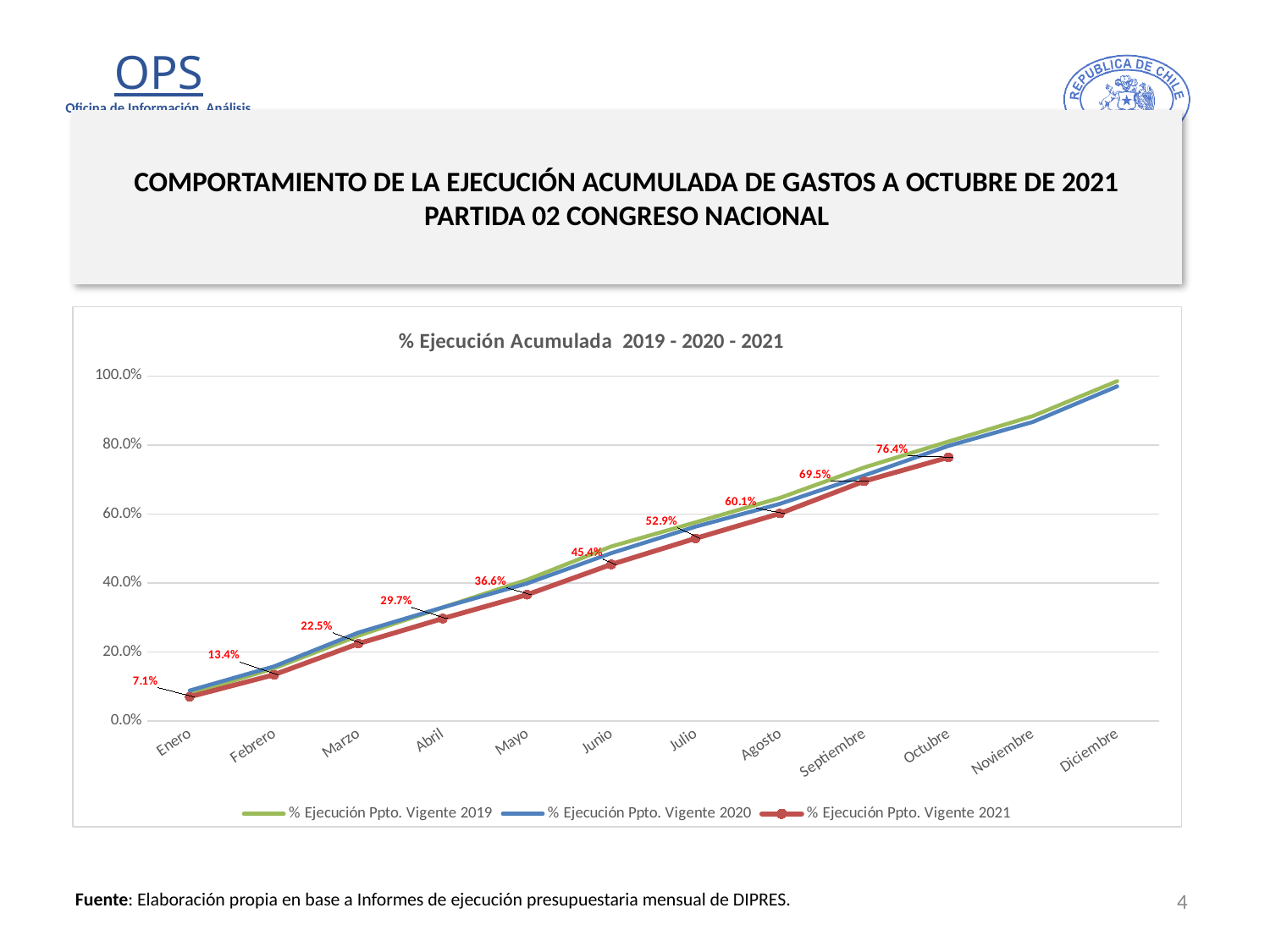
What kind of chart is shown? Line chart What is the value of % Ejecución Ppto. Vigente 2021 for Octubre? 76.4% How many series does the legend list? 3 By how many percentage points does the 2021 value for Octubre exceed the 2021 value for Septiembre? 6.9 Which month has the lowest labelled value for % Ejecución Ppto. Vigente 2021? Enero Is the value for % Ejecución Ppto. Vigente 2019 in Diciembre greater or less than 80.0%? greater Do the values of the series rise or fall from Enero to Diciembre? Rise What is the value of % Ejecución Ppto. Vigente 2021 for Junio? 45.4% What is the value of % Ejecución Ppto. Vigente 2021 for Enero? 7.1% How many months are shown on the x axis? 12 Which month has the highest labelled value for % Ejecución Ppto. Vigente 2021? Octubre What is the title of the chart? % Ejecución Acumulada 2019 - 2020 - 2021